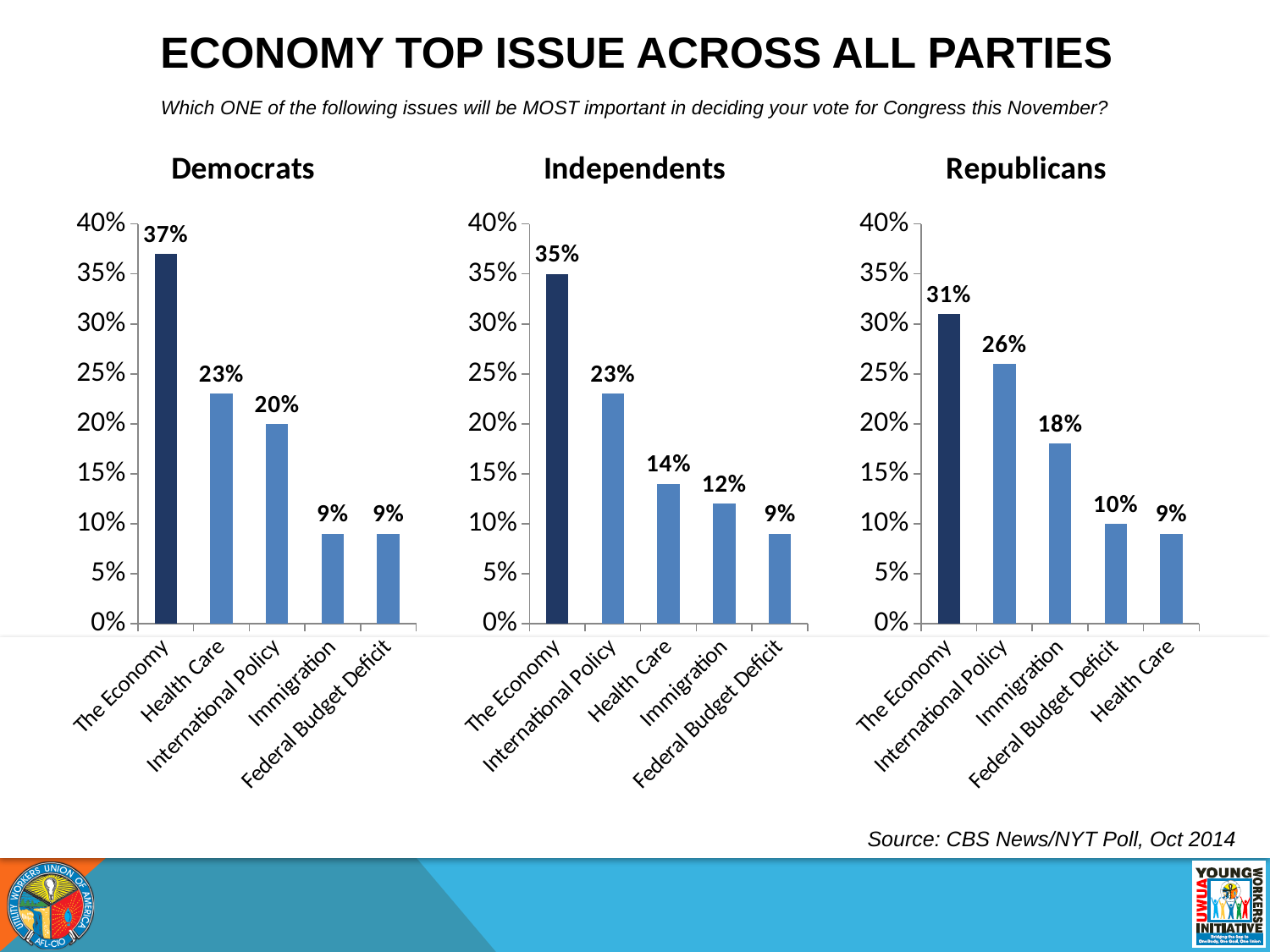
In the Independents chart, what is the value for Health Care? 14% In the Democrats chart, do the values rise or fall from left to right along the x axis? Fall In the Independents chart, which is larger, International Policy or Immigration? International Policy In the Democrats chart, is the value for International Policy greater or less than 15%? greater In the Republicans chart, what is the value for Immigration? 18% In the Independents chart, which category has the lowest value? Federal Budget Deficit In the Republicans chart, which category has the highest value? The Economy In the Republicans chart, what is the difference between International Policy and Federal Budget Deficit? 16% How many categories are shown in the Independents chart? 5 In the Democrats chart, what is the difference between The Economy and Health Care? 14% In the Democrats chart, what is the value for The Economy? 37% What kind of chart is the Republicans chart? Bar chart